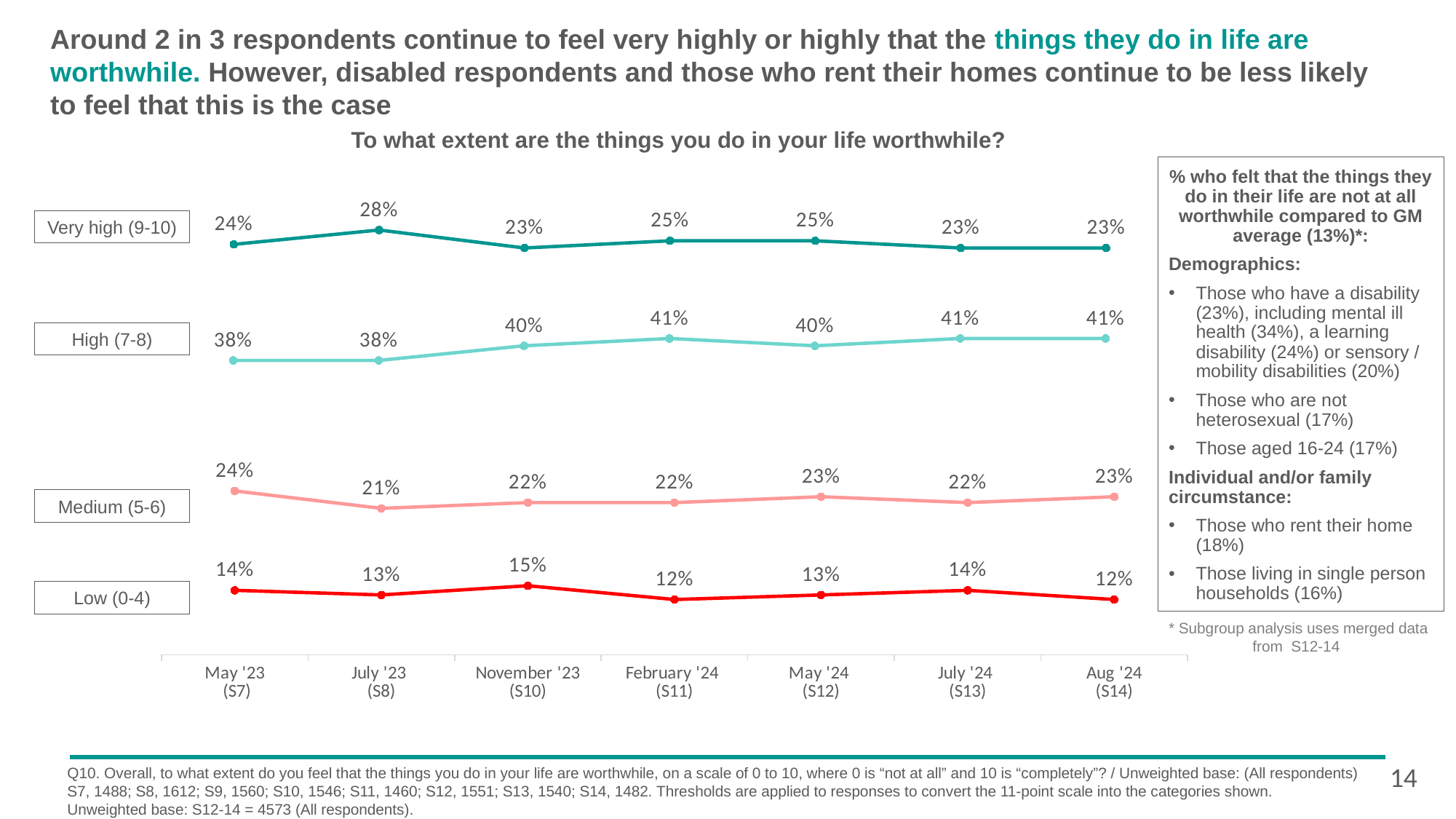
What is the value for Low (0-4) in November '23 (S10)? 15% What is the value for Very high (9-10) in July '23 (S8)? 28% Which is larger in May '24 (S12): the Medium (5-6) value or the Low (0-4) value? Medium (5-6) Which series has the lowest value in Aug '24 (S14)? Low (0-4) How many time points are plotted along the x axis? 7 What is the difference between the High (7-8) and Very high (9-10) values in February '24 (S11)? 16 percentage points In which survey wave is the Very high (9-10) series at its highest? July '23 (S8) What type of chart is shown on the slide? Line chart How many series does the chart show? 4 What is the value for High (7-8) in Aug '24 (S14)? 41% What is the title of the chart? To what extent are the things you do in your life worthwhile? What is the value for Medium (5-6) in May '23 (S7)? 24%